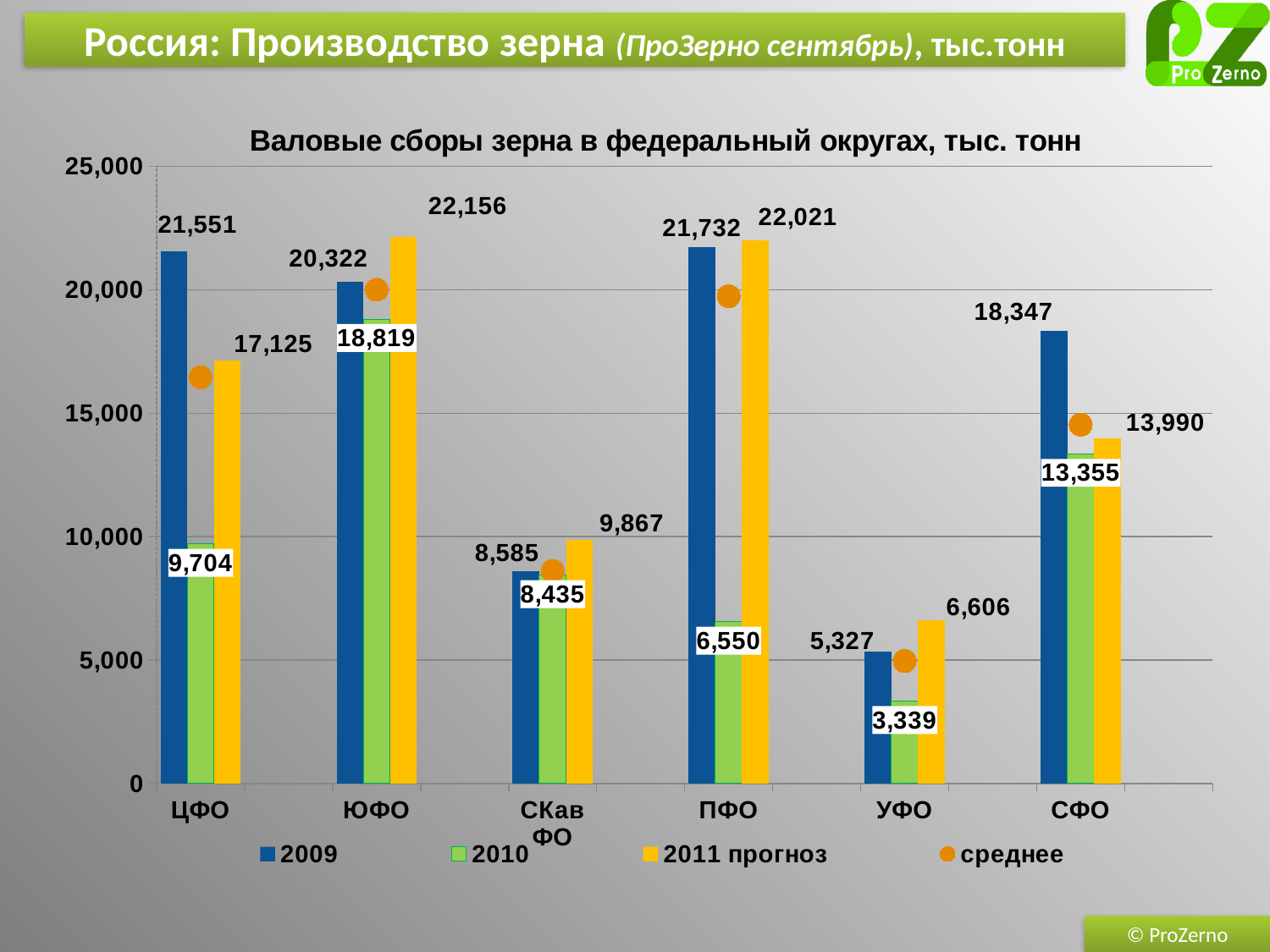
How many federal districts are shown on the x axis? 6 How many series does the legend list? 4 What is the 2011 прогноз value for ЮФО? 22,156 What is the title of the chart? Валовые сборы зерна в федеральный округах, тыс. тонн What is the difference between the 2009 and 2010 values for ЦФО? 11,847 What is the difference between the 2011 прогноз and 2009 values for ПФО? 289 Is the среднее value for ЦФО greater or less than 15,000? greater What is the 2009 value for ЦФО? 21,551 Which federal district has the lowest 2010 value? УФО Which federal district has the highest 2011 прогноз value? ЮФО For СФО, which is larger: the 2010 value or the 2011 прогноз value? 2011 прогноз What is the 2010 value for ПФО? 6,550